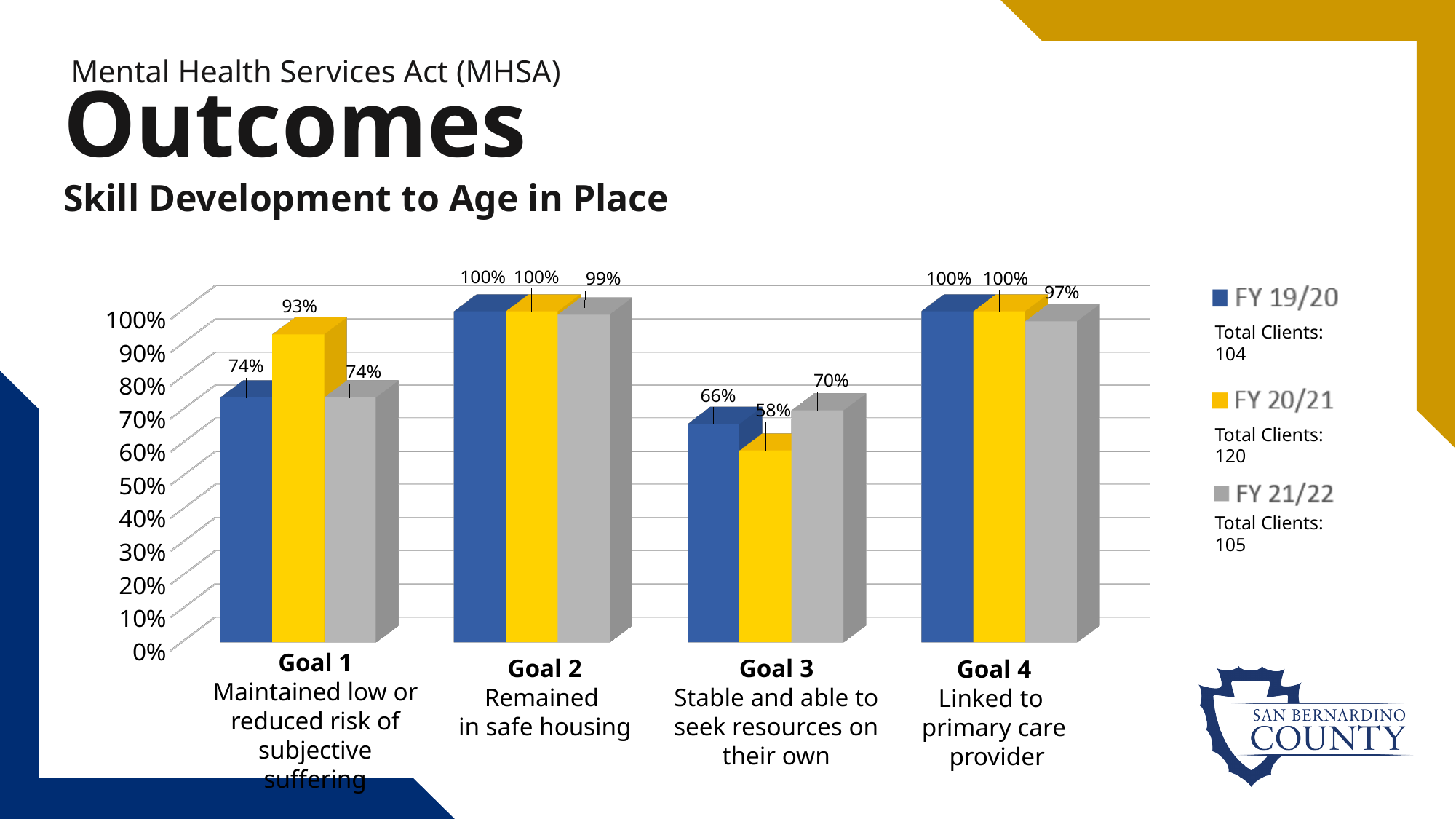
What is the difference between the FY 20/21 and FY 19/20 values for Goal 1? 19% For Goal 3, which is larger: the FY 19/20 value or the FY 20/21 value? FY 19/20 What is the FY 21/22 value for Goal 4? 97% What is the FY 20/21 value for Goal 1? 93% How many goals are shown on the x axis? 4 What kind of chart is shown? Bar chart What is the FY 21/22 value for Goal 3? 70% According to the legend, how many total clients were there in FY 20/21? 120 Which goal has the lowest FY 20/21 value? Goal 3 What is the FY 19/20 value for Goal 3? 66% How many series does the legend list? 3 Which goal has the highest FY 21/22 value? Goal 2